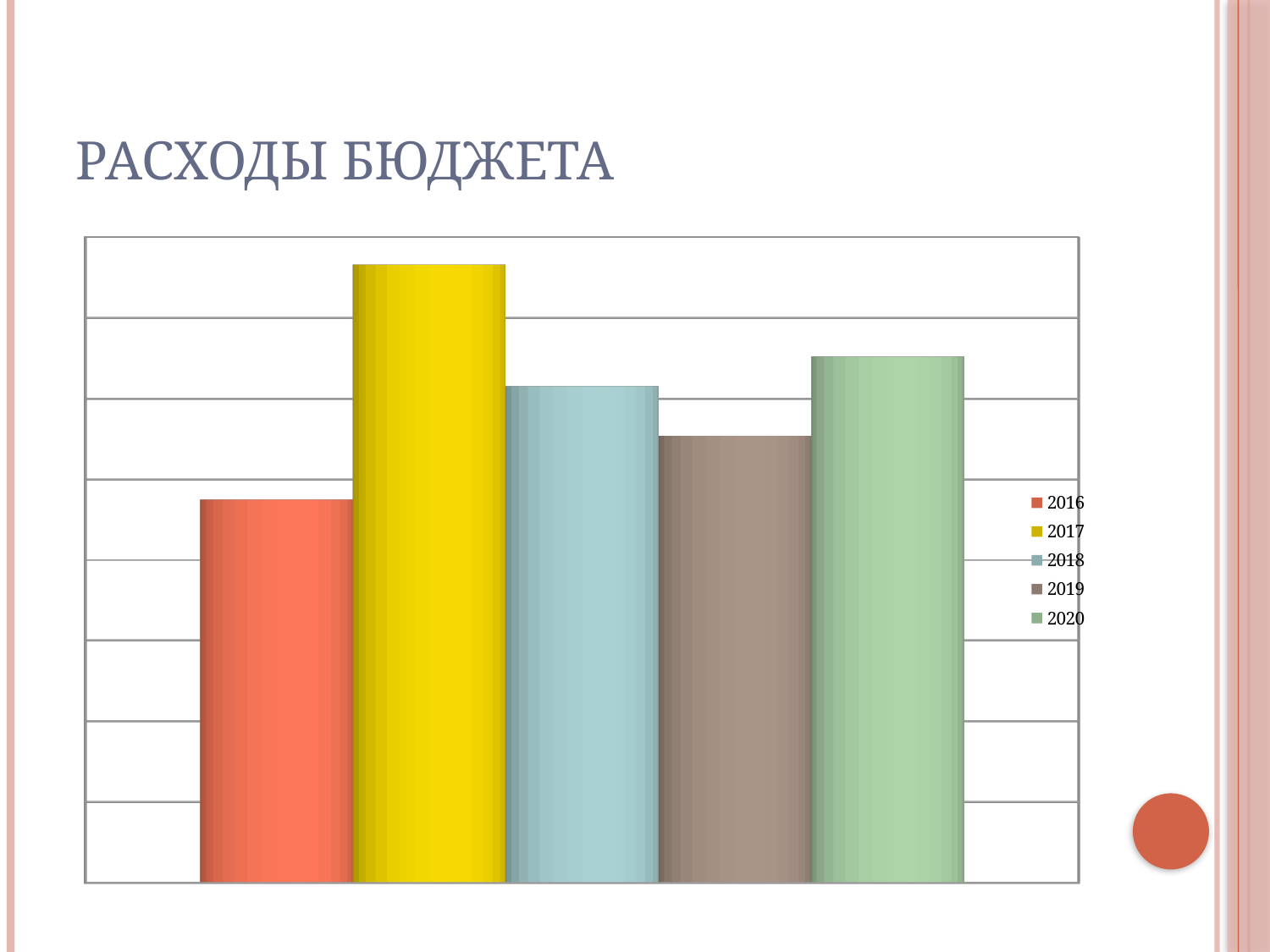
Which year has the highest bar in the chart? 2017 What kind of chart is shown on the slide? bar chart Which is larger, the bar for 2016 or the bar for 2019? 2019 Which year has the lowest bar in the chart? 2016 Which is larger, the bar for 2020 or the bar for 2018? 2020 Which is larger, the bar for 2018 or the bar for 2019? 2018 How many entries does the chart's legend list? 5 How many bars are plotted in the chart? 5 What is the title of the slide with the chart? РАСХОДЫ БЮДЖЕТА What colour is the bar for 2017 in the chart? yellow Which year is listed first in the chart's legend? 2016